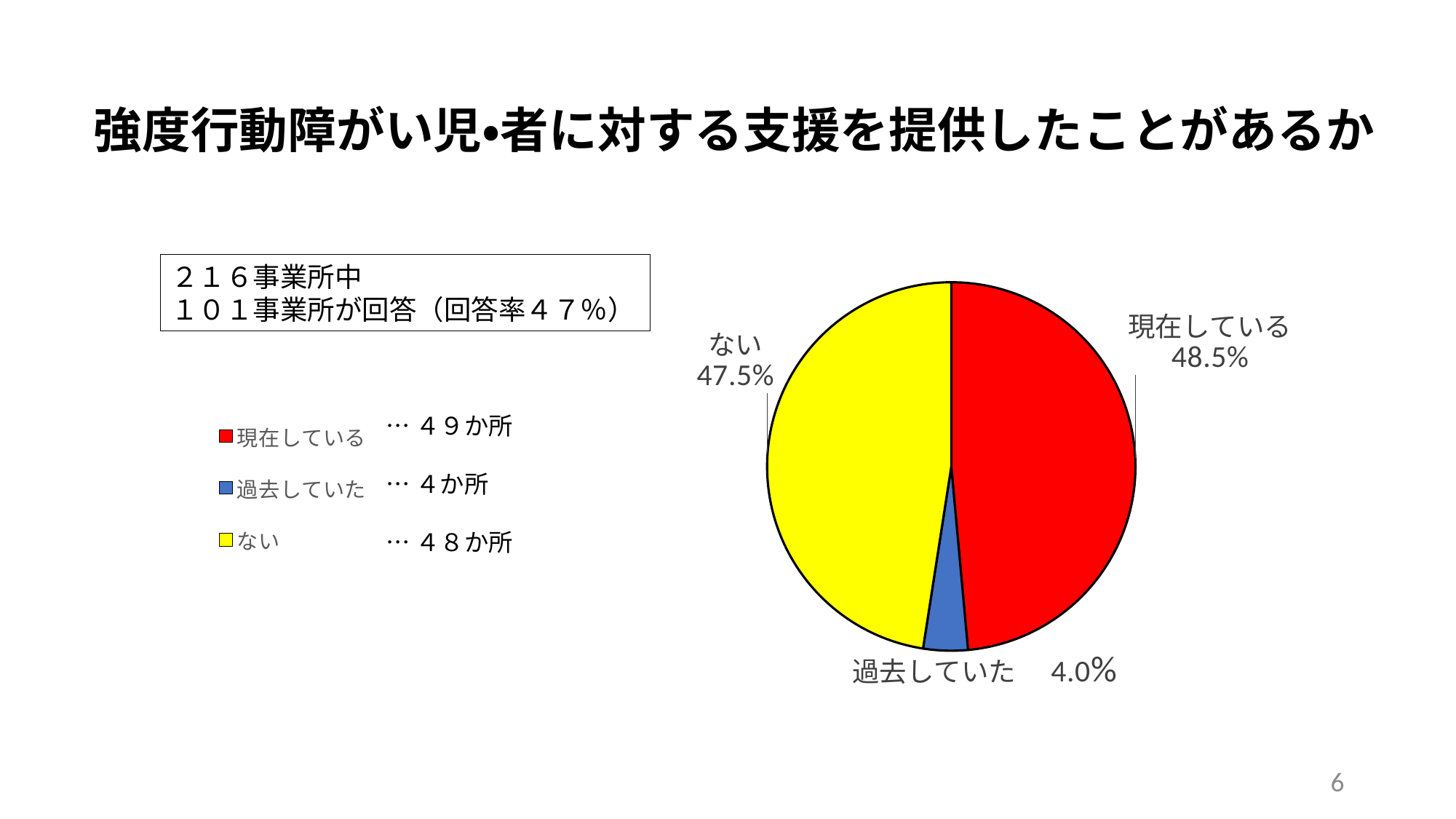
How many slices does the pie chart have? 3 How many entries does the legend list? 3 Which slice is larger, 現在している or ない? 現在している What colour is the ない slice of the pie chart? yellow According to the legend, how many locations (か所) answered 現在している? ４９か所 What percentage of the pie is labelled ない? 47.5% What percentage of the pie is labelled 現在している? 48.5% What kind of chart is shown on the slide? pie chart Which category has the smallest slice of the pie? 過去していた What is the difference in percentage points between the 現在している slice and the ない slice? 1.0 Which category has the largest slice of the pie? 現在している What percentage of the pie is labelled 過去していた? 4.0%